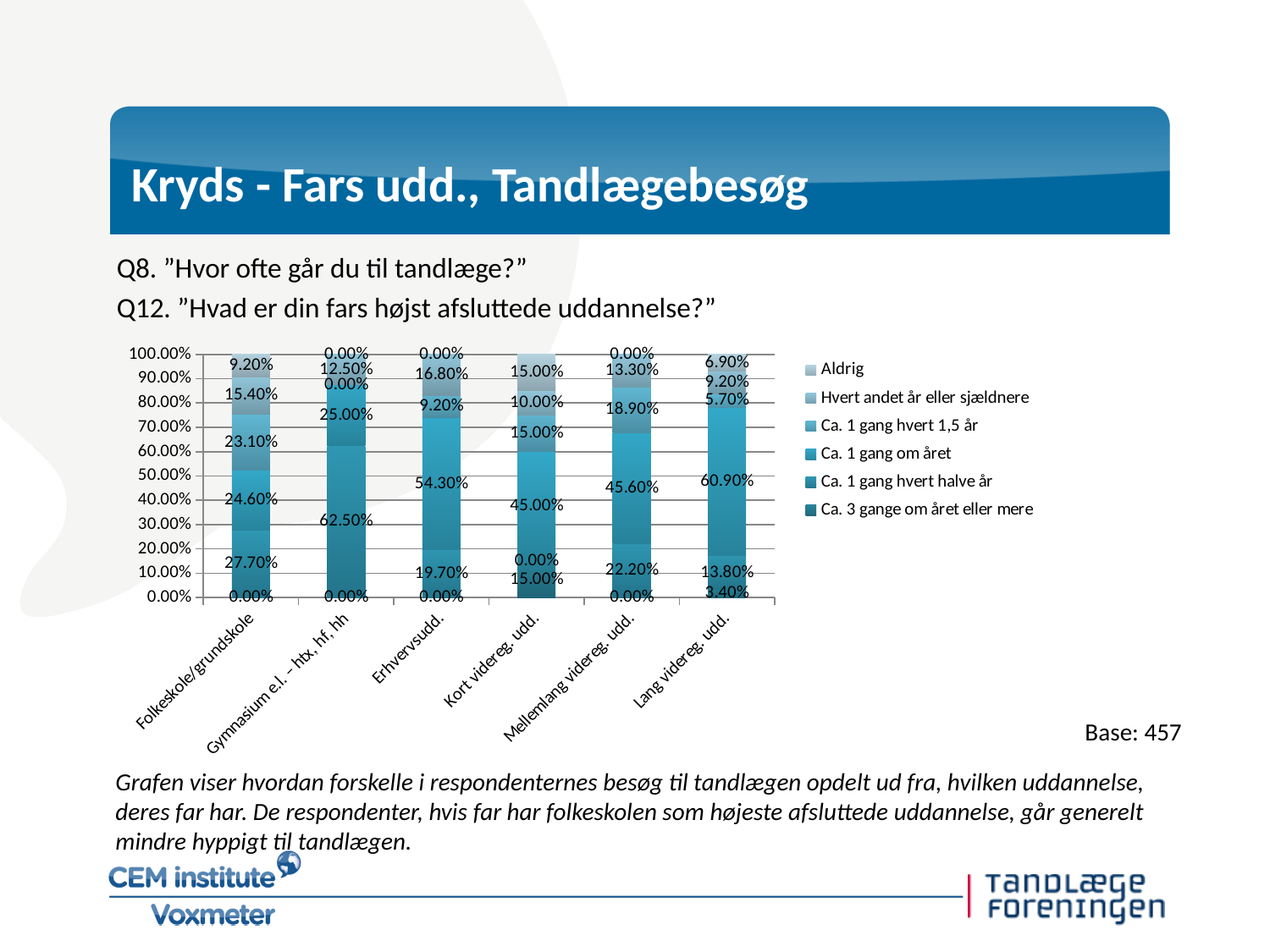
What is the value of the 'Ca. 1 gang hvert 1,5 år' segment for Mellemlang videreg. udd.? 18.90% What is the value of the 'Ca. 3 gange om året eller mere' segment for Lang videreg. udd.? 3.40% For Folkeskole/grundskole, what is the difference between the 'Ca. 1 gang hvert halve år' segment (27.70%) and the 'Ca. 1 gang om året' segment (24.60%)? 3.10 percentage points What is the value of the 'Aldrig' segment for Folkeskole/grundskole? 9.20% Which has the larger 'Ca. 1 gang hvert halve år' segment: Erhvervsudd. or Mellemlang videreg. udd.? Mellemlang videreg. udd. What is the value of the 'Ca. 1 gang hvert halve år' segment for Gymnasium e.l. – htx, hf, hh? 62.50% How many series does the legend list? 6 Which category has the largest 'Ca. 1 gang hvert halve år' segment? Gymnasium e.l. – htx, hf, hh What is the value of the 'Aldrig' segment for Kort videreg. udd.? 15.00% Which entry appears first (at the top) in the chart legend? Aldrig How many education categories are shown on the x axis? 6 What kind of chart is shown on the slide? Stacked bar chart